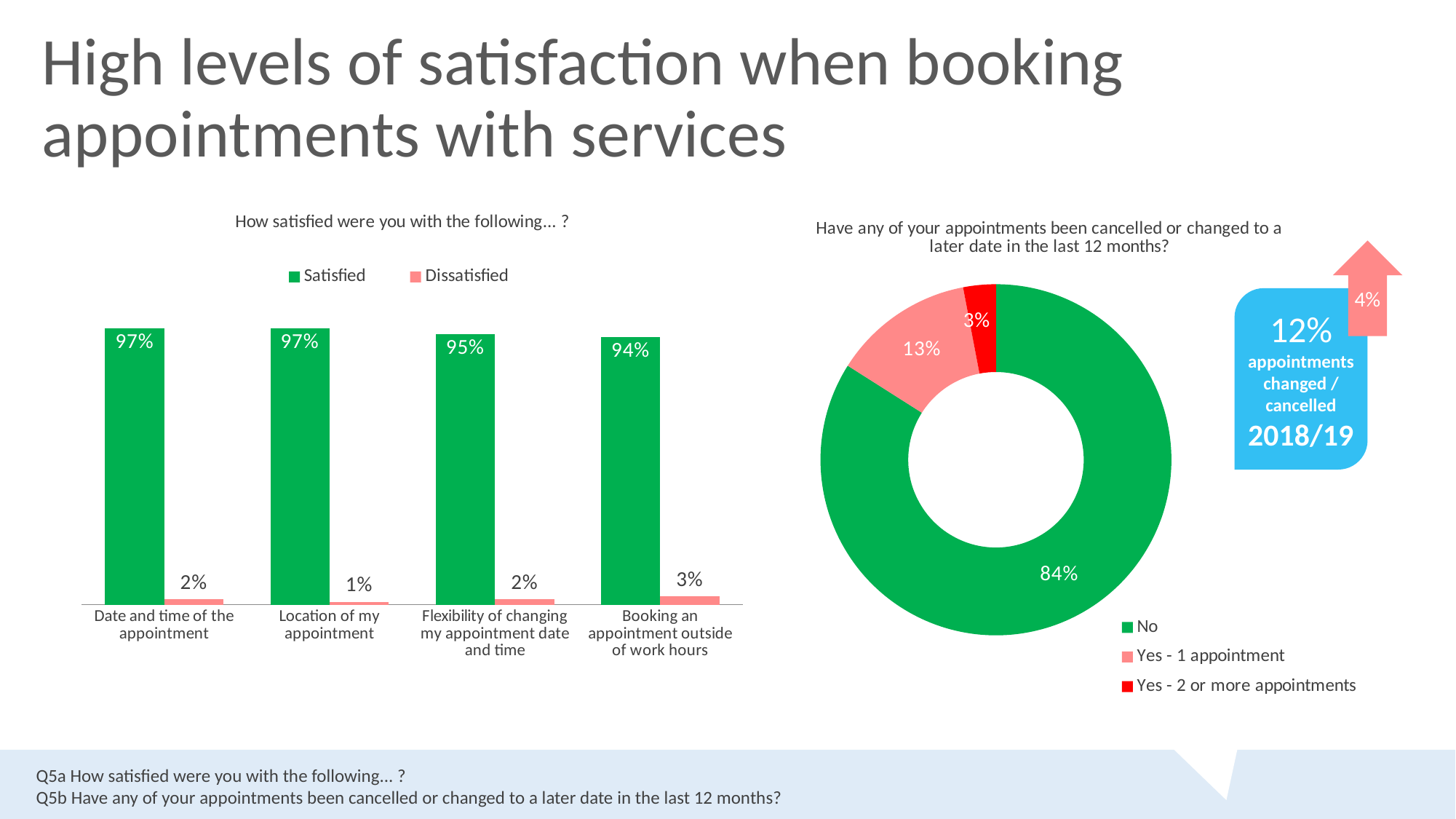
In the 'Have any of your appointments been cancelled or changed to a later date in the last 12 months?' chart, what is the value for 'Yes - 2 or more appointments'? 3% In the 'How satisfied were you with the following... ?' chart, which category has the lowest Satisfied value? Booking an appointment outside of work hours In the 'Have any of your appointments been cancelled or changed to a later date in the last 12 months?' chart, what share is 'No'? 84% In the 'How satisfied were you with the following... ?' chart, which category has the lowest Dissatisfied value? Location of my appointment In the 'How satisfied were you with the following... ?' chart, what is the Dissatisfied value for 'Booking an appointment outside of work hours'? 3% In the 'How satisfied were you with the following... ?' chart, what is the Satisfied value for 'Location of my appointment'? 97% In the 'How satisfied were you with the following... ?' chart, how many series does the legend list? 2 In the 'Have any of your appointments been cancelled or changed to a later date in the last 12 months?' chart, which is larger: 'Yes - 1 appointment' or 'Yes - 2 or more appointments'? Yes - 1 appointment In the 'How satisfied were you with the following... ?' chart, how many categories are shown on the x axis? 4 What kind of chart is the 'How satisfied were you with the following... ?' chart? Bar chart What kind of chart is the 'Have any of your appointments been cancelled or changed to a later date in the last 12 months?' chart? Doughnut chart In the 'How satisfied were you with the following... ?' chart, what is the difference between the Satisfied values for 'Date and time of the appointment' and 'Booking an appointment outside of work hours'? 3%